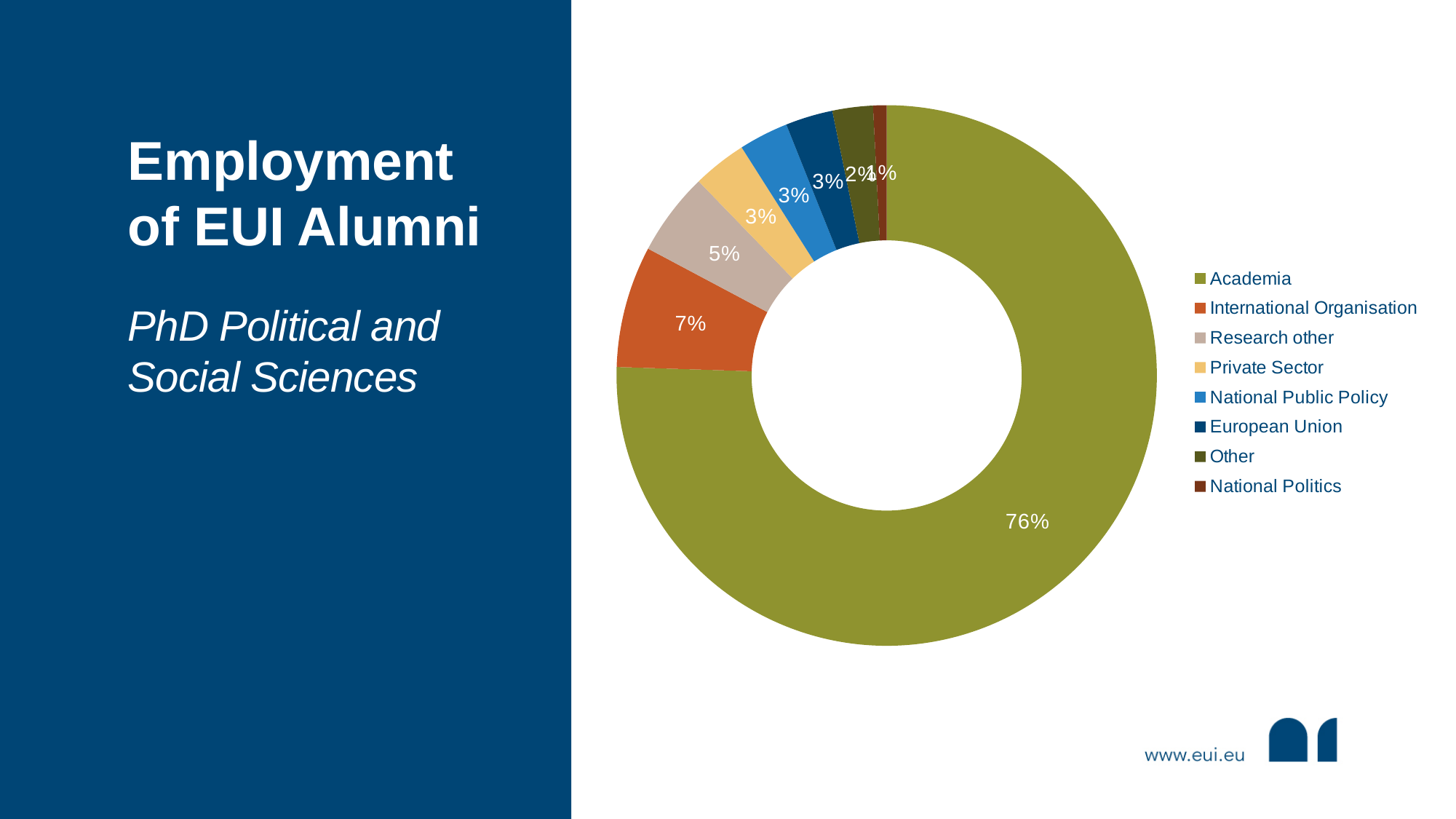
Which employment category has the largest share? Academia What colour is the Academia segment of the chart? olive green How many employment categories does the chart show? 8 What percentage of alumni work in an International Organisation? 7% What is the value shown for Research other? 5% Which is larger, the share for International Organisation or the share for Research other? International Organisation What is the difference in percentage points between Academia and International Organisation? 69 Which employment category has the smallest share? National Politics What percentage of alumni are in the Private Sector? 3% What kind of chart is used on this slide? doughnut chart What share of EUI PhD Political and Social Sciences alumni are employed in Academia? 76% What is the value for the Other category? 2%